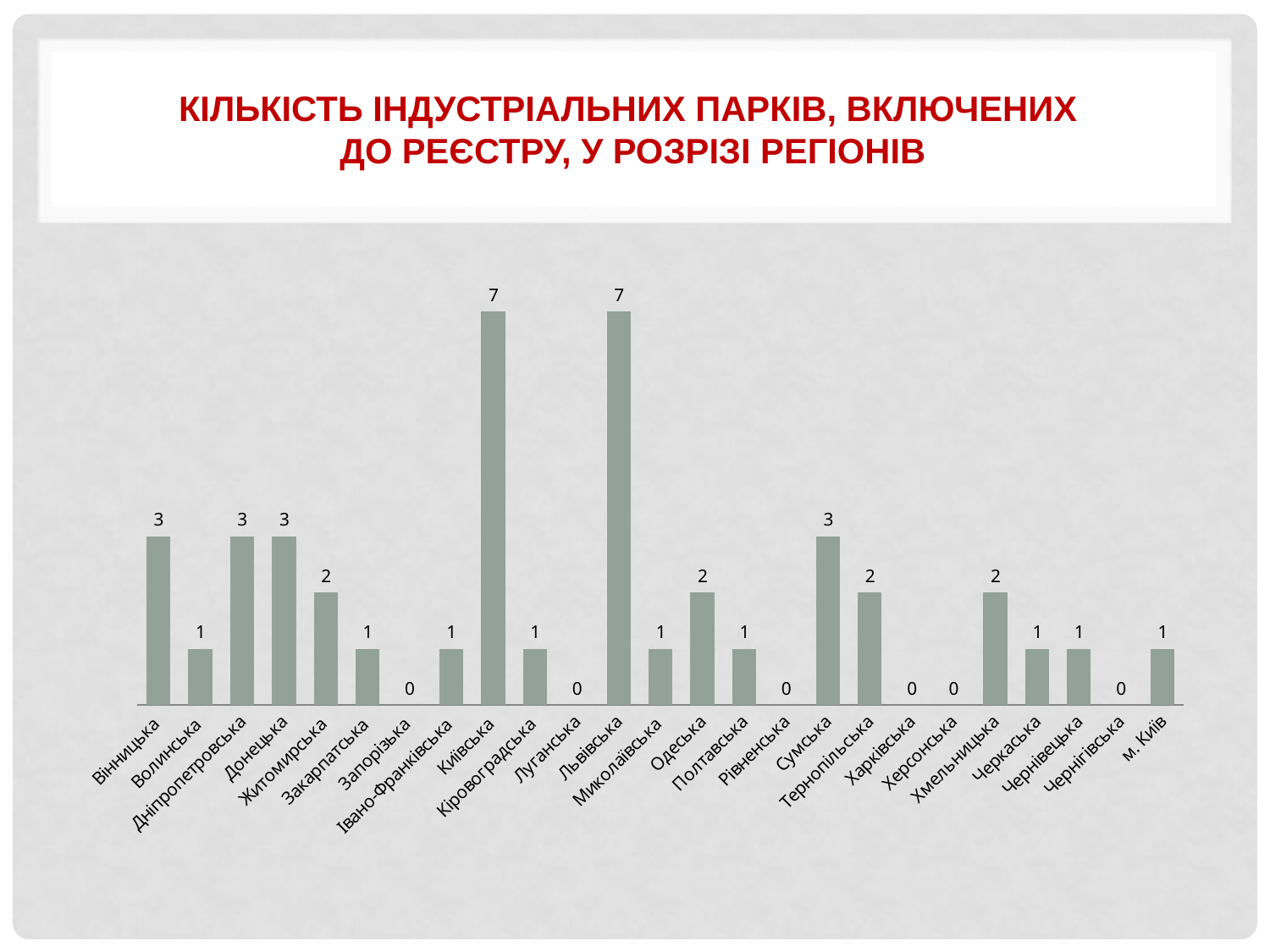
How many regions have a value of 0? 6 What type of chart is shown on the slide? bar chart What is the difference between the values for Львівська and Хмельницька? 5 What is the highest value shown in the chart? 7 Which two regions share the highest value in the chart? Київська and Львівська What is the value for Сумська? 3 How many regions (categories) are shown on the x axis? 25 Which is larger, the value for Донецька or the value for Тернопільська? Донецька What is the value for м. Київ? 1 What is the value for Одеська? 2 What is the value for Київська? 7 What is the title of the chart? Кількість індустріальних парків, включених до реєстру, у розрізі регіонів